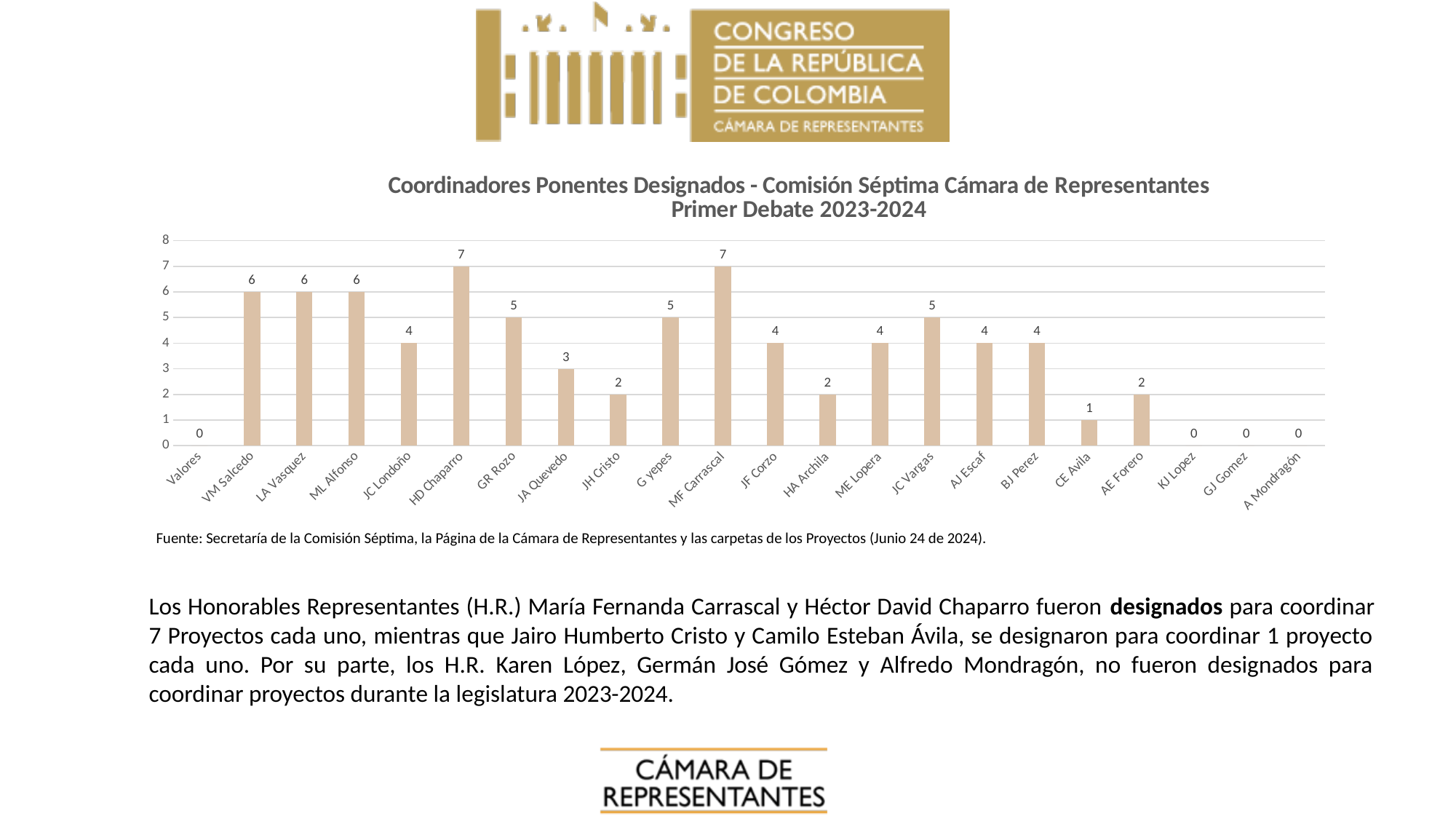
Which category has the lowest non-zero value? CE Avila What is the value for HD Chaparro? 7 Is the value for JC Vargas greater or less than 4? greater What is the value for CE Avila? 1 What kind of chart is shown on the slide? Bar chart What is the difference between the values for GR Rozo and HA Archila? 3 What is the value for KJ Lopez? 0 What is the difference between the values for HD Chaparro and JA Quevedo? 4 What is the value for JA Quevedo? 3 How many categories are shown on the x axis of the chart? 22 Which two categories share the highest value in the chart? HD Chaparro and MF Carrascal Which is larger, the value for VM Salcedo or the value for JC Londoño? VM Salcedo